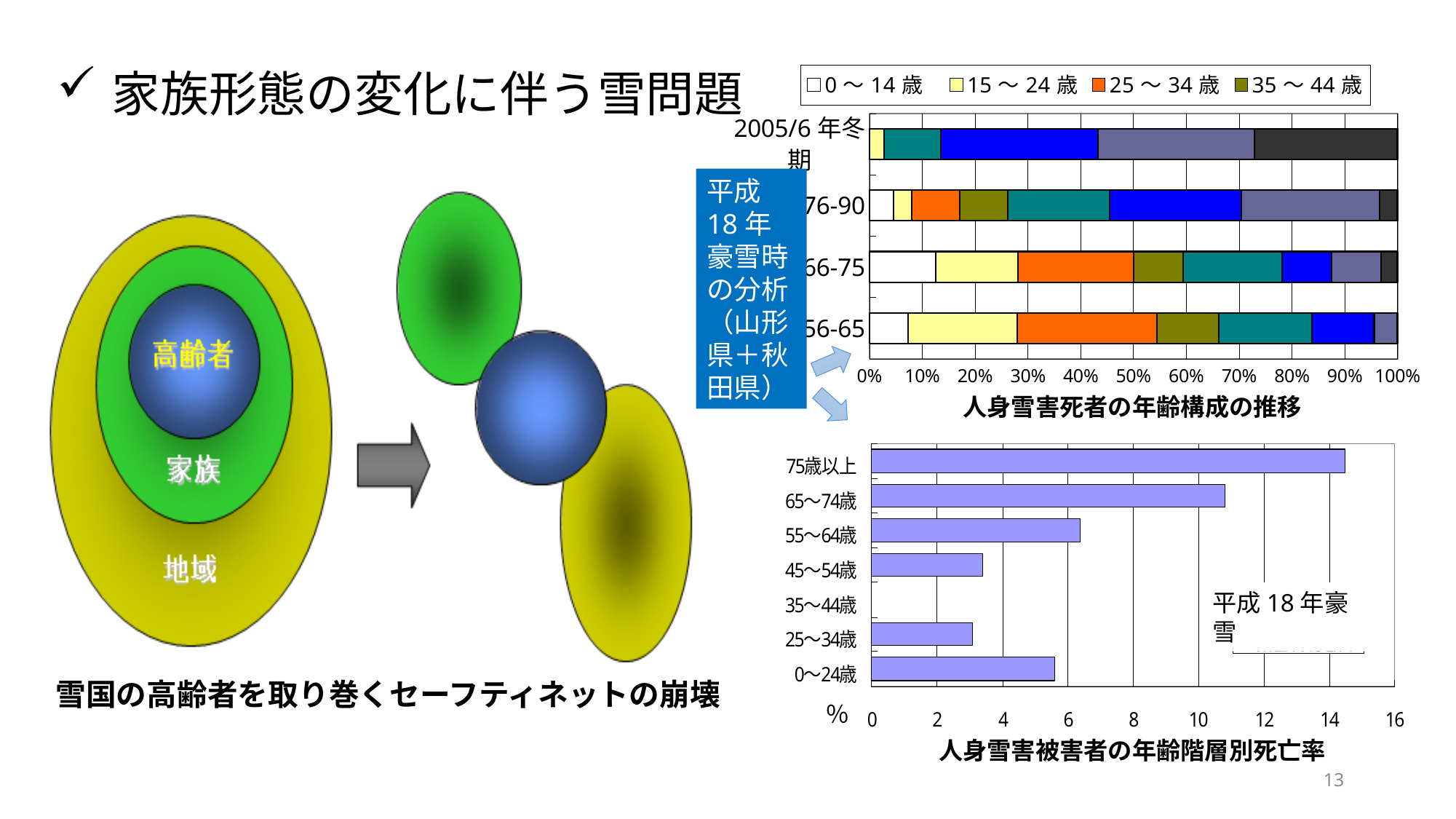
In the chart titled 人身雪害被害者の年齢階層別死亡率, which is larger, the value for 65～74歳 or the value for 55～64歳? 65～74歳 What kind of chart is the chart titled 人身雪害被害者の年齢階層別死亡率? bar chart In the chart titled 人身雪害被害者の年齢階層別死亡率, is the value for 45～54歳 greater or less than 4? less What kind of chart is the chart titled 人身雪害死者の年齢構成の推移? stacked bar chart In the chart titled 人身雪害被害者の年齢階層別死亡率, is the value for 75歳以上 greater or less than 14? greater In the chart titled 人身雪害被害者の年齢階層別死亡率, which age group has the highest value? 75歳以上 In the chart titled 人身雪害被害者の年齢階層別死亡率, is the value for 0～24歳 greater or less than 6? less In the chart titled 人身雪害死者の年齢構成の推移, what is the maximum value shown on the x axis? 100% In the chart titled 人身雪害被害者の年齢階層別死亡率, what unit is shown on the x axis? % In the chart titled 人身雪害被害者の年齢階層別死亡率, how many age groups are shown? 7 In the chart titled 人身雪害被害者の年齢階層別死亡率, which age group has the lowest value? 35～44歳